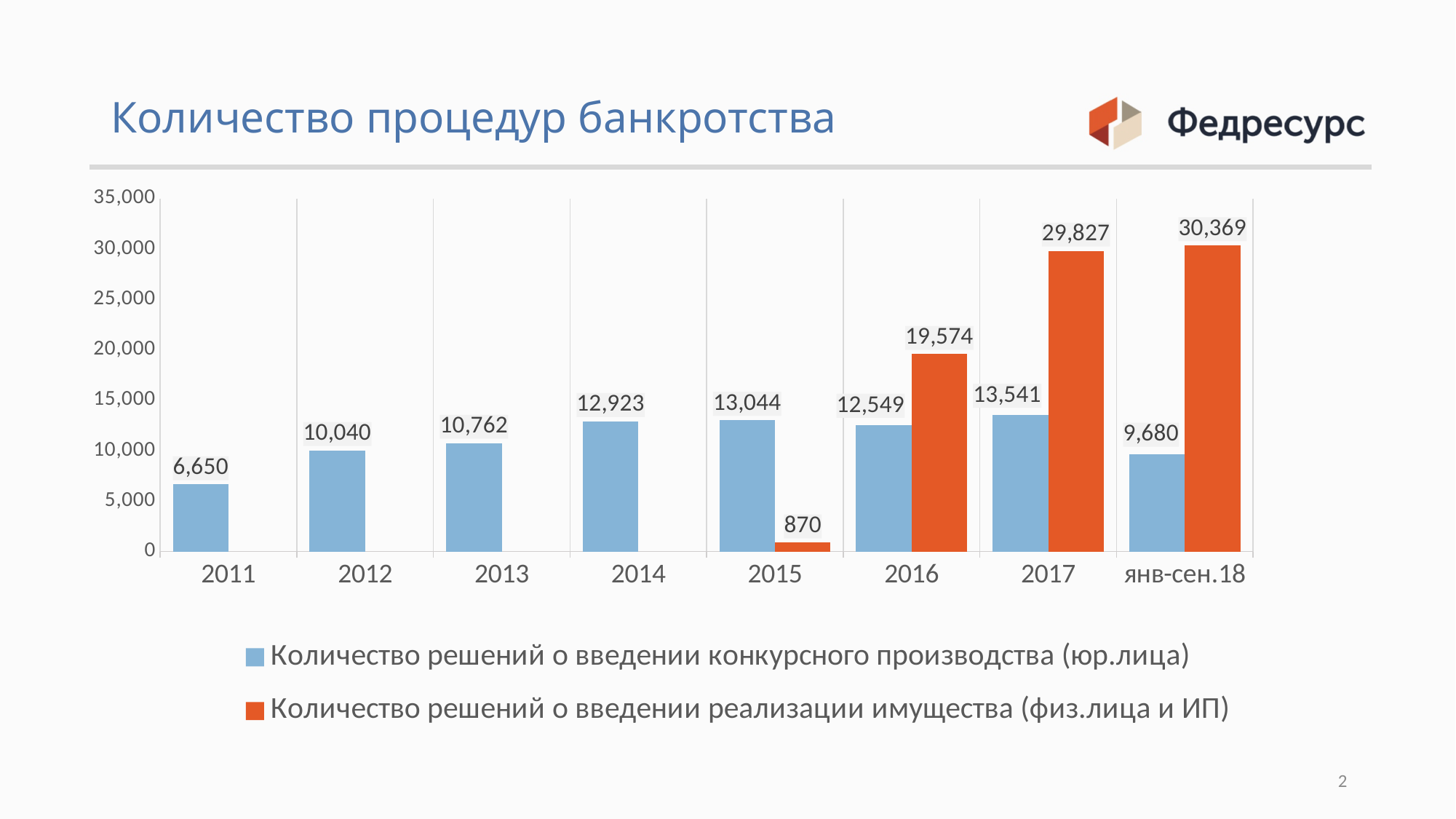
How many categories are shown on the x axis? 8 What is the title of the chart on the slide? Количество процедур банкротства What type of chart is shown on the slide? bar chart What is the value for 2011 in the series "Количество решений о введении конкурсного производства (юр.лица)"? 6,650 What is the difference between the 2017 and 2016 values in the series "Количество решений о введении реализации имущества (физ.лица и ИП)"? 10,253 Which category has the lowest value in the series "Количество решений о введении конкурсного производства (юр.лица)"? 2011 How many series does the legend list? 2 Does the series "Количество решений о введении реализации имущества (физ.лица и ИП)" rise or fall from 2015 to янв-сен.18? rise What is the value for 2016 in the series "Количество решений о введении реализации имущества (физ.лица и ИП)"? 19,574 Which category has the highest value in the series "Количество решений о введении конкурсного производства (юр.лица)"? 2017 What is the value for 2015 in the series "Количество решений о введении реализации имущества (физ.лица и ИП)"? 870 In 2017, which series has the larger value: "конкурсного производства (юр.лица)" or "реализации имущества (физ.лица и ИП)"? Количество решений о введении реализации имущества (физ.лица и ИП)